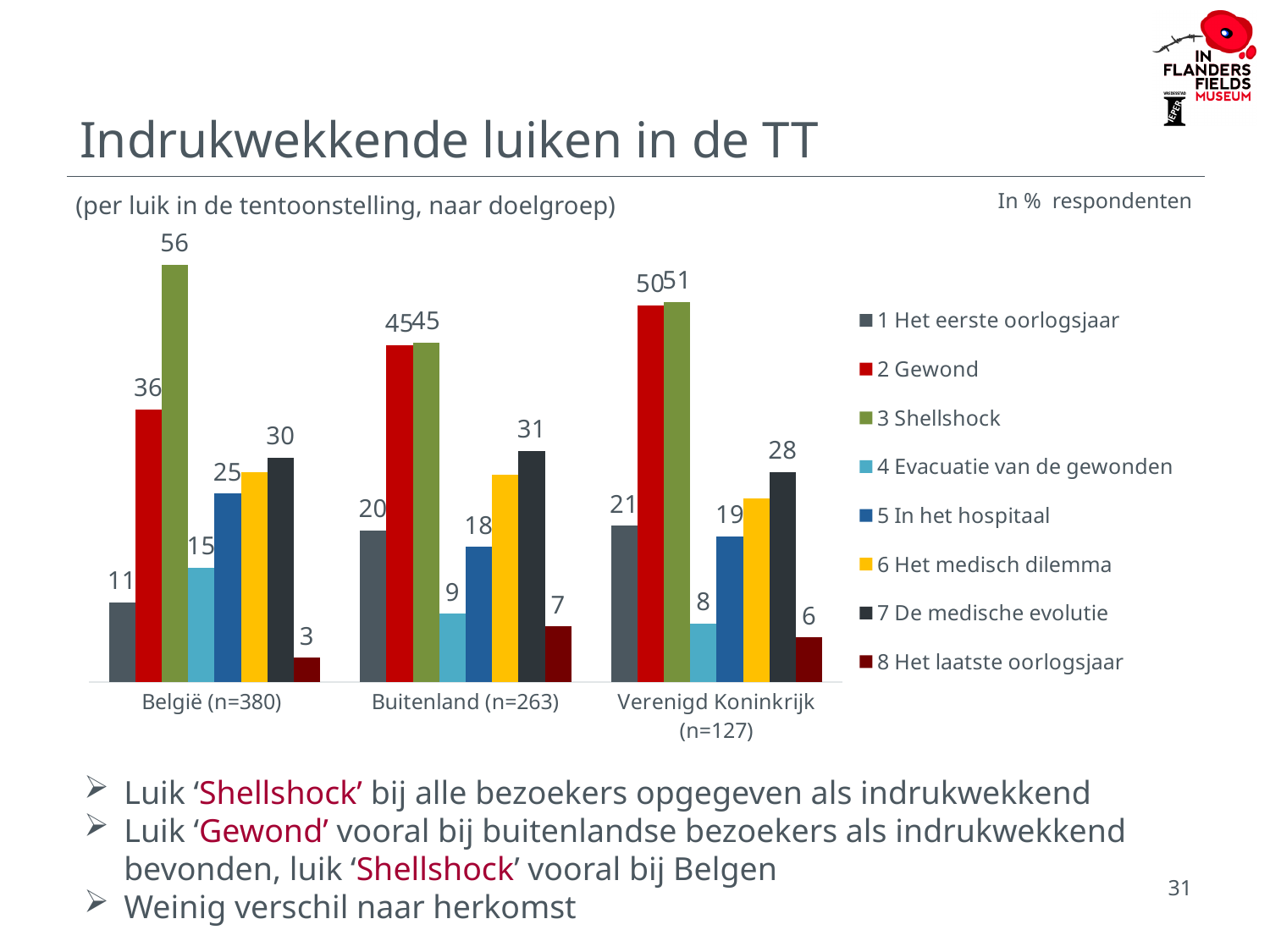
Which series has the lowest value in the Buitenland (n=263) group? 8 Het laatste oorlogsjaar What is the difference between the '3 Shellshock' value for België (n=380) and for Verenigd Koninkrijk (n=127)? 5 What type of chart is shown on the slide? Bar chart How many groups (categories) are shown on the x axis of the chart? 3 What is the value for '4 Evacuatie van de gewonden' in the België (n=380) group? 15 Which series has the highest value in the België (n=380) group? 3 Shellshock How many series does the chart legend list? 8 What is the difference between the '7 De medische evolutie' value for Buitenland (n=263) and for Verenigd Koninkrijk (n=127)? 3 What is the value for '3 Shellshock' in the België (n=380) group? 56 What is the value for '2 Gewond' in the Buitenland (n=263) group? 45 What is the value for '8 Het laatste oorlogsjaar' in the Verenigd Koninkrijk (n=127) group? 6 Which group has the larger value for '2 Gewond': België (n=380) or Verenigd Koninkrijk (n=127)? Verenigd Koninkrijk (n=127)